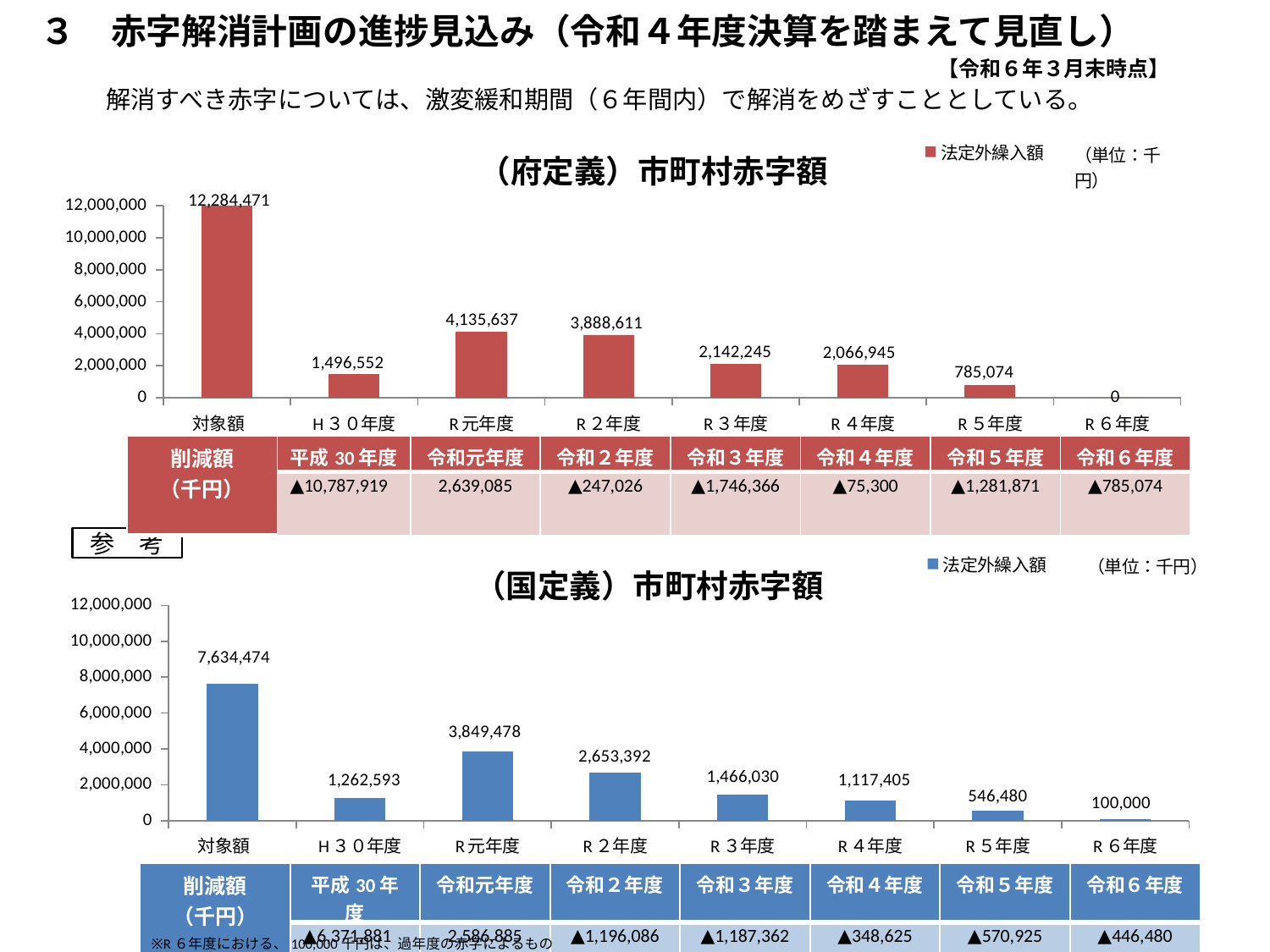
In the top chart titled （府定義）市町村赤字額, what is the value for 対象額? 12,284,471 How many categories are shown on the x axis of the top chart titled （府定義）市町村赤字額? 8 In the top chart titled （府定義）市町村赤字額, what is the value for Ｒ５年度? 785,074 In the top chart titled （府定義）市町村赤字額, what is the difference between the values for Ｒ元年度 and Ｒ２年度? 247,026 In the bottom chart titled （国定義）市町村赤字額, which category has the highest value? 対象額 In the bottom chart titled （国定義）市町村赤字額, what is the value for Ｒ元年度? 3,849,478 What kind of chart is the top chart titled （府定義）市町村赤字額? Bar chart In the bottom chart titled （国定義）市町村赤字額, which is larger, the value for Ｈ３０年度 or the value for Ｒ３年度? Ｒ３年度 In the bottom chart titled （国定義）市町村赤字額, what is the value for Ｒ６年度? 100,000 In the bottom chart titled （国定義）市町村赤字額, what is the difference between the values for Ｒ３年度 and Ｒ４年度? 348,625 In the top chart titled （府定義）市町村赤字額, which category has the lowest value? Ｒ６年度 How many series does the legend of the bottom chart titled （国定義）市町村赤字額 list? 1